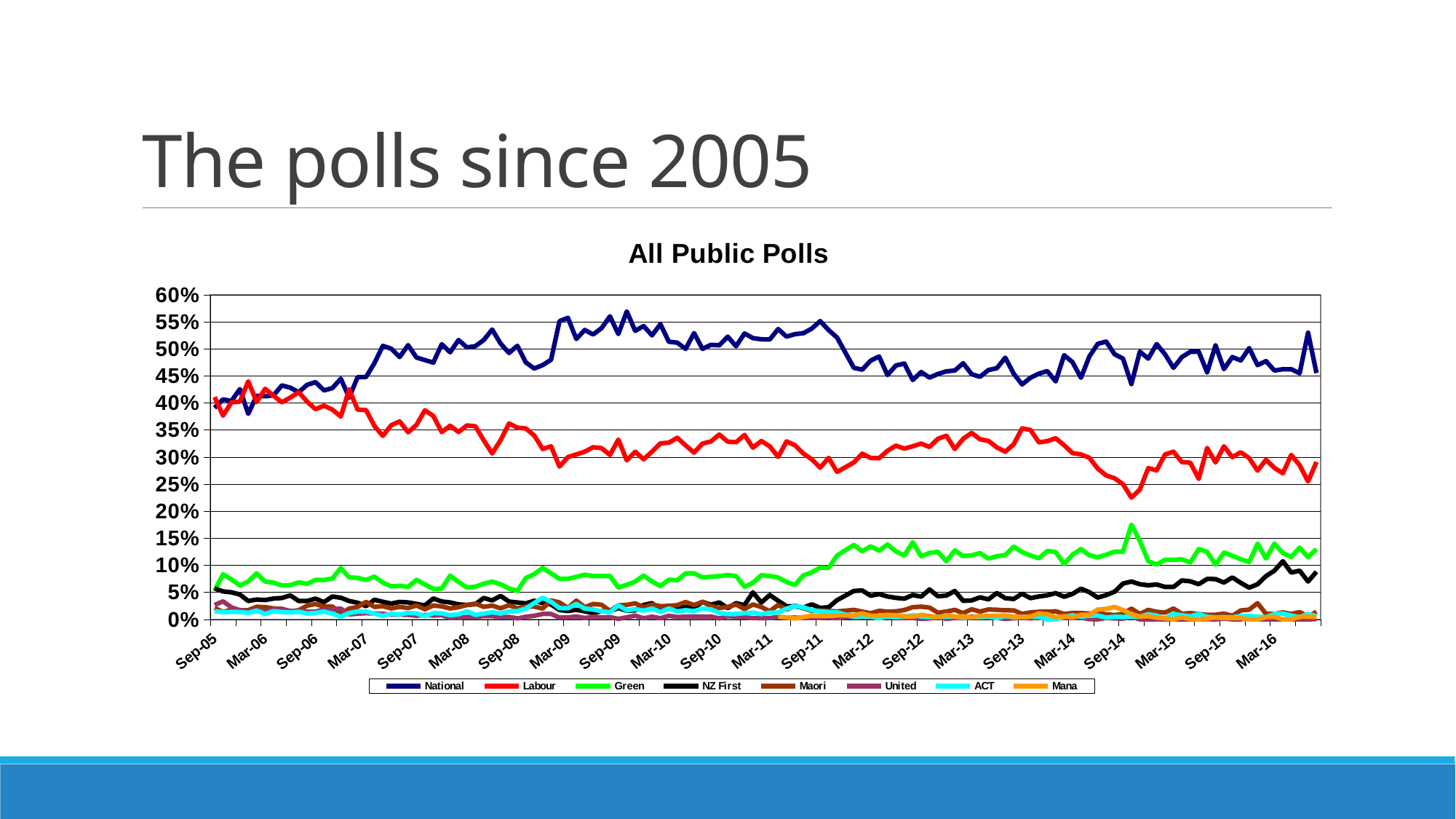
Is the value for National at Sep-05 greater or less than 45%? less Overall, does the Labour line rise or fall from Sep-05 to Mar-16? fall Which is larger at Mar-16, National or Labour? National Is the value for Green at Mar-12 greater or less than 10%? greater Which is larger at Mar-16, Green or NZ First? Green Which series has the highest value at Sep-09? National What is the title of the chart? All Public Polls Is the value for National at Sep-09 greater or less than 50%? greater How many series does the legend of the chart list? 8 Overall, does the Green line rise or fall from Sep-05 to Mar-16? rise What kind of chart is shown on the slide? Line chart